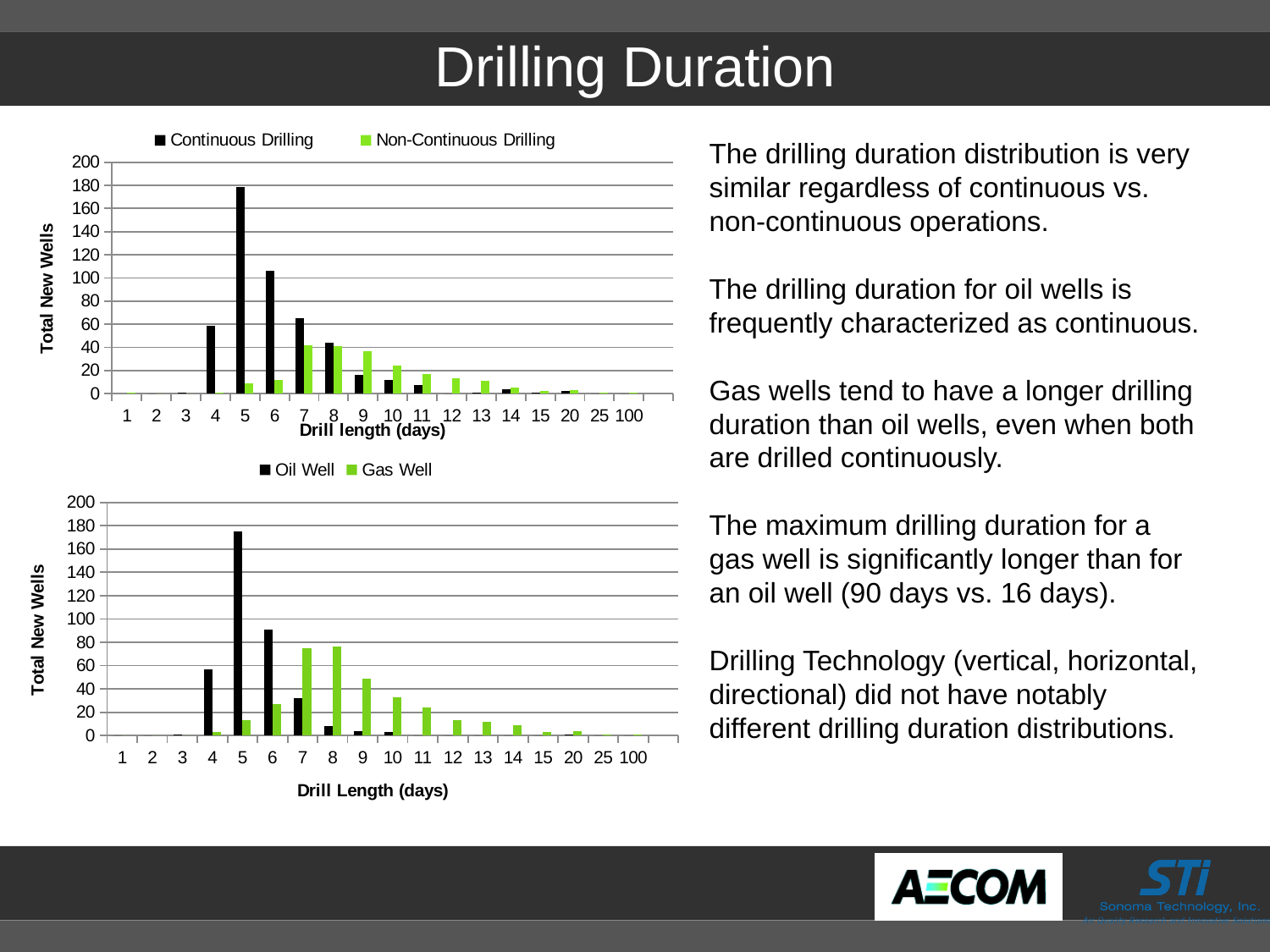
In the top chart, is the Continuous Drilling value at drill length 5 greater or less than 160? greater In the bottom chart, is the Gas Well value at drill length 5 greater or less than 20? less In the top chart, does the Continuous Drilling value rise or fall from drill length 5 to drill length 10? fall How many drill length categories are shown on the x axis of the top chart? 18 In the bottom chart, at drill length 7, which series is larger: Oil Well or Gas Well? Gas Well In the bottom chart, is the Oil Well value at drill length 6 greater or less than 80? greater In the bottom chart, at which drill length is the Oil Well value highest? 5 What kind of chart is the top chart (Continuous Drilling vs Non-Continuous Drilling)? bar chart In the top chart, at drill length 5, which series is larger: Continuous Drilling or Non-Continuous Drilling? Continuous Drilling How many series does the legend of the bottom chart (Oil Well vs Gas Well) list? 2 In the top chart, at which drill length is the Continuous Drilling value highest? 5 What is the y-axis title of the bottom chart? Total New Wells